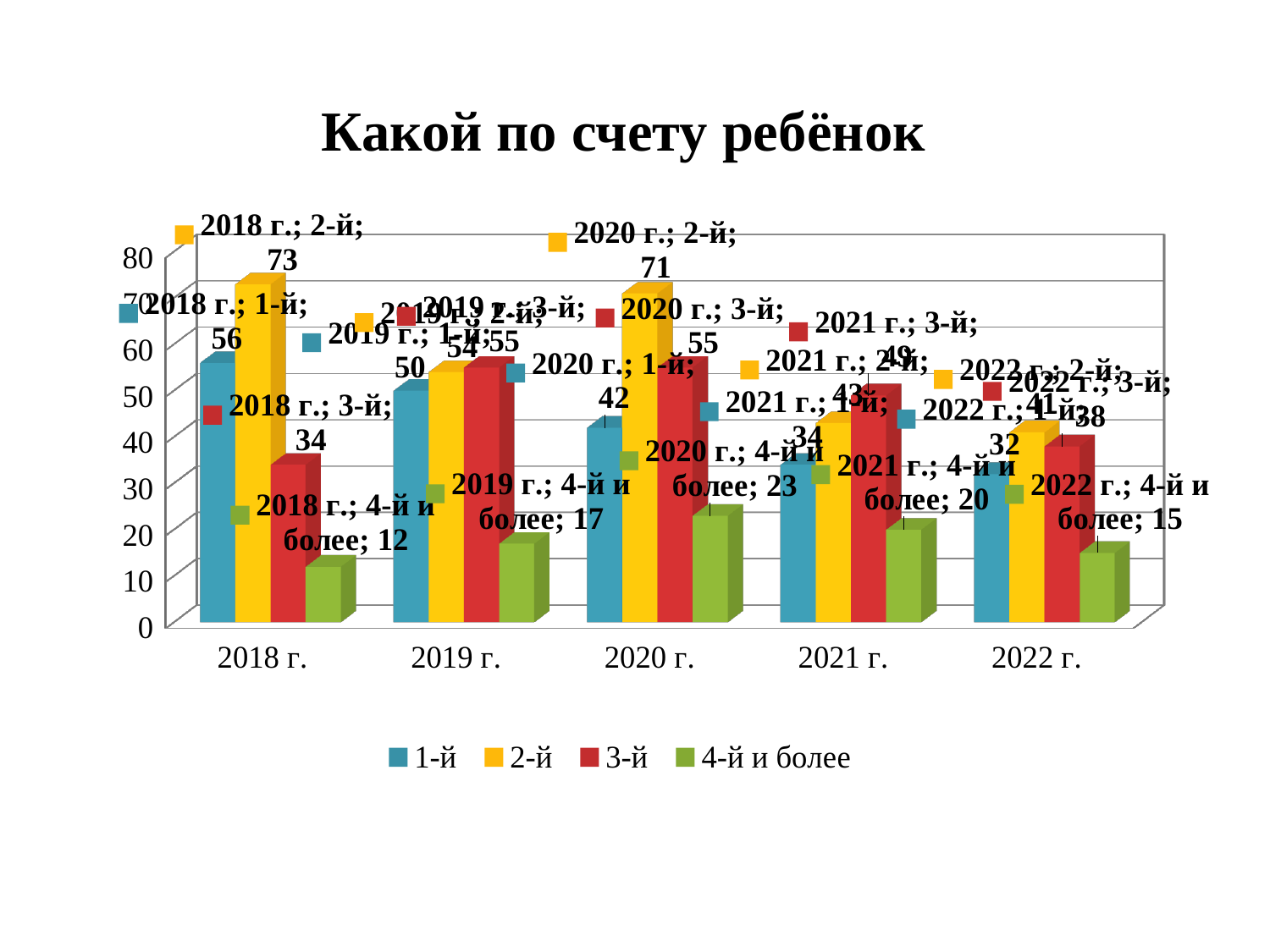
How many series does the legend list? 4 What is the title of the chart? Какой по счету ребёнок Which is larger: the 1-й value in 2020 г. or the 1-й value in 2021 г.? 2020 г. What kind of chart is shown on the slide? bar chart What is the difference between the 2-й and 3-й values in 2018 г.? 39 In which year is the 4-й и более series lowest? 2018 г. How many year categories are shown on the x axis? 5 What is the value for 4-й и более in 2020 г.? 23 What is the value for 1-й in 2022 г.? 32 Does the 1-й series rise or fall from 2018 г. to 2022 г.? fall In which year is the 2-й series highest? 2018 г. What is the value for 2-й in 2018 г.? 73